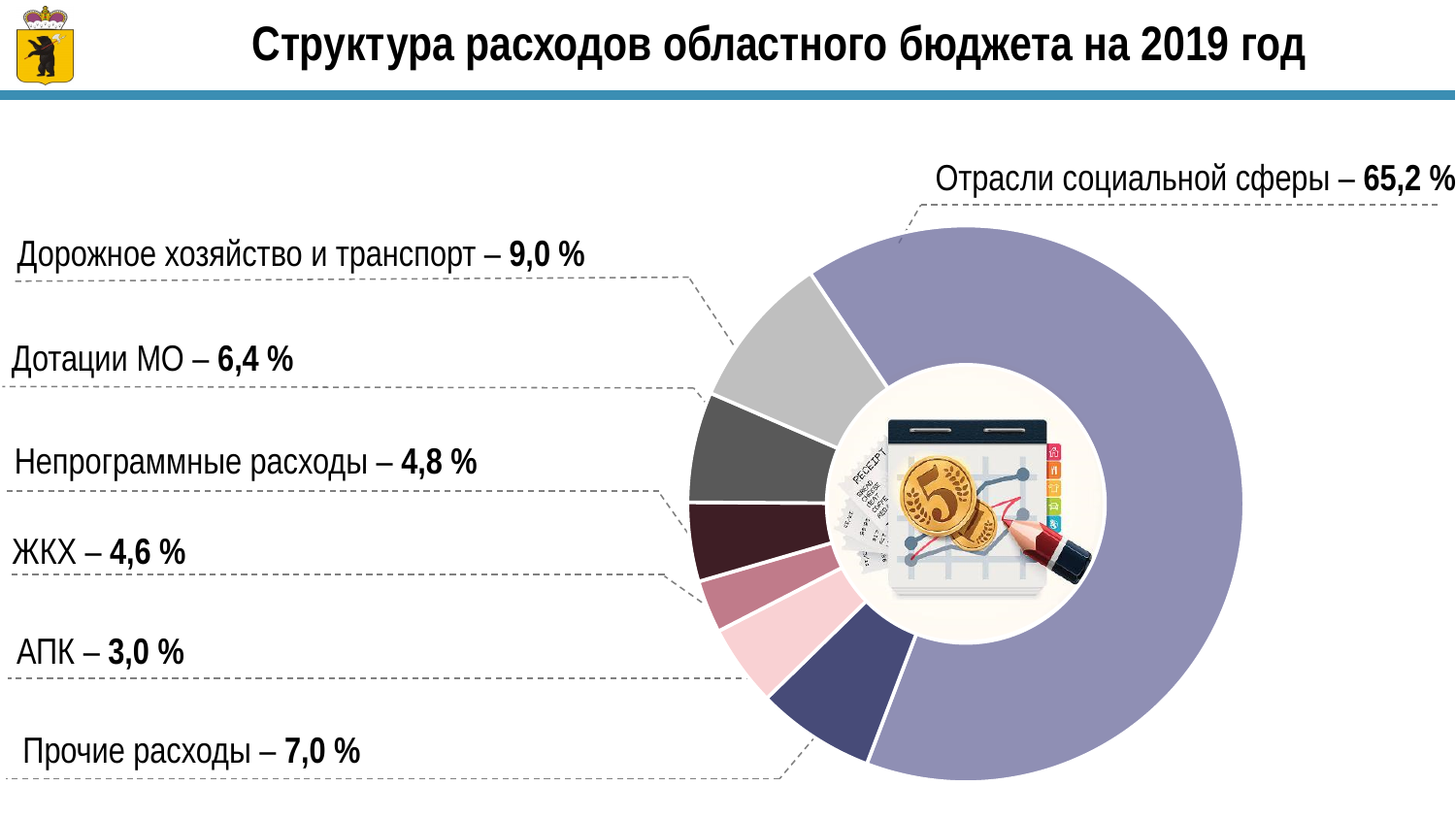
What is the difference between the shares of Дорожное хозяйство и транспорт and Дотации МО? 2,6 % What is the value for Прочие расходы? 7,0 % How many expenditure categories are shown in the chart? 7 What is the title of the slide? Структура расходов областного бюджета на 2019 год What is the value shown for Дорожное хозяйство и транспорт? 9,0 % What share of the regional budget expenditure goes to Отрасли социальной сферы? 65,2 % Which is larger: the share for Непрограммные расходы or the share for Прочие расходы? Прочие расходы Which category has the smallest share of the budget expenditure? АПК What kind of chart is used on the slide? Doughnut chart Which category has the largest share of the budget expenditure? Отрасли социальной сферы What is the combined share of ЖКХ and АПК? 7,6 % What percentage is shown for Дотации МО? 6,4 %